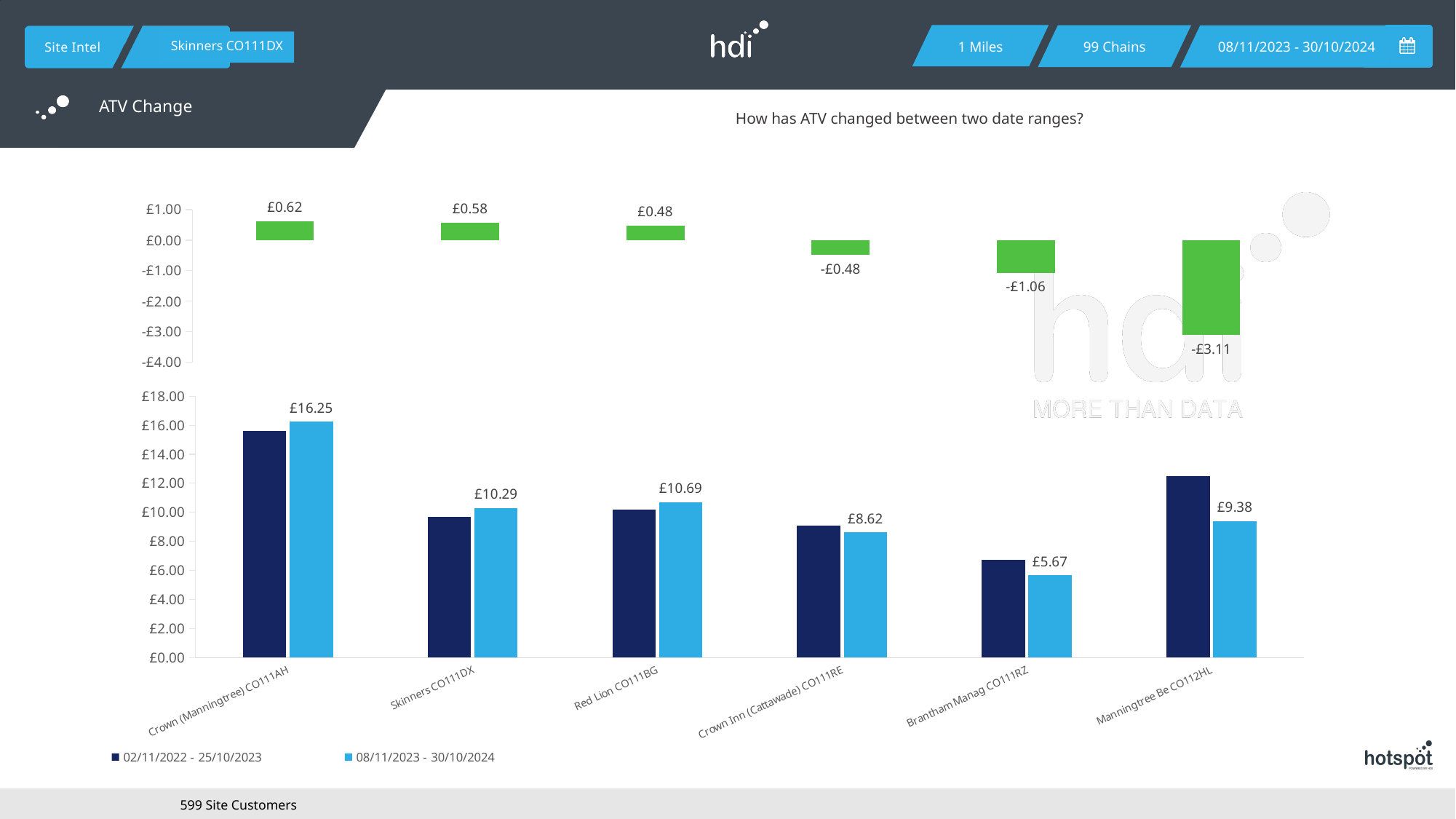
In the bottom chart, how many series does the legend list? 2 In the top chart, what is the difference between the ATV change for Crown (Manningtree) CO111AH and Red Lion CO111BG? £0.14 In the top chart, which site has the lowest ATV change? Manningtree Be CO112HL In the bottom chart, which site has the larger 08/11/2023 - 30/10/2024 value, Red Lion CO111BG or Skinners CO111DX? Red Lion CO111BG In the top chart, what is the ATV change for Manningtree Be CO112HL? -£3.11 In the bottom chart, is the 02/11/2022 - 25/10/2023 value for Manningtree Be CO112HL greater or less than £12.00? greater In the bottom chart, what is the value for Crown Inn (Cattawade) CO111RE in the 08/11/2023 - 30/10/2024 series? £8.62 What kind of chart is the bottom chart? bar chart In the top chart, what is the ATV change for Skinners CO111DX? £0.58 In the top chart, how many sites are plotted? 6 In the top chart, which site has the highest ATV change? Crown (Manningtree) CO111AH In the bottom chart, what is the value for Brantham Manag CO111RZ in the 08/11/2023 - 30/10/2024 series? £5.67